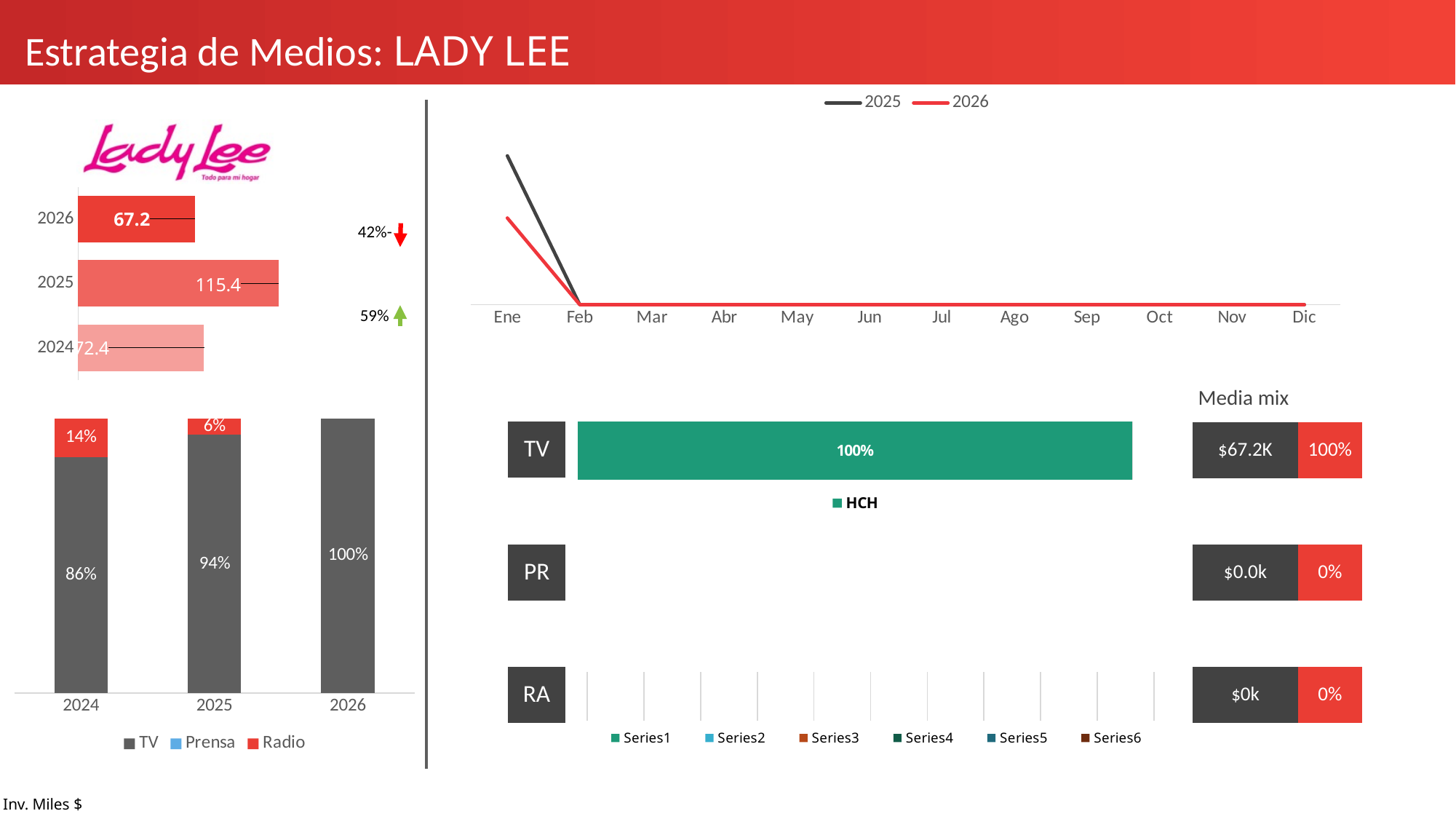
In the top-left horizontal bar chart, what is the difference between the 2025 and 2026 values? 48.2 In the top-left horizontal bar chart, which year has the highest value? 2025 In the top-left horizontal bar chart, what is the value for 2026? 67.2 In the bottom-left stacked bar chart, what is the TV share for 2024? 86% What type of chart is the top-right chart showing months Ene to Dic? Line chart In the bottom-left stacked bar chart, how many series does the legend list? 3 In the top-left horizontal bar chart, how many years are shown? 3 In the bottom-left stacked bar chart, what is the Radio share for 2025? 6% In the top-left horizontal bar chart, which year has the lowest value? 2026 In the bottom-left stacked bar chart, is the TV share larger in 2025 or in 2024? 2025 In the top-right line chart, how many series does the legend list? 2 In the top-left horizontal bar chart, what is the value for 2025? 115.4